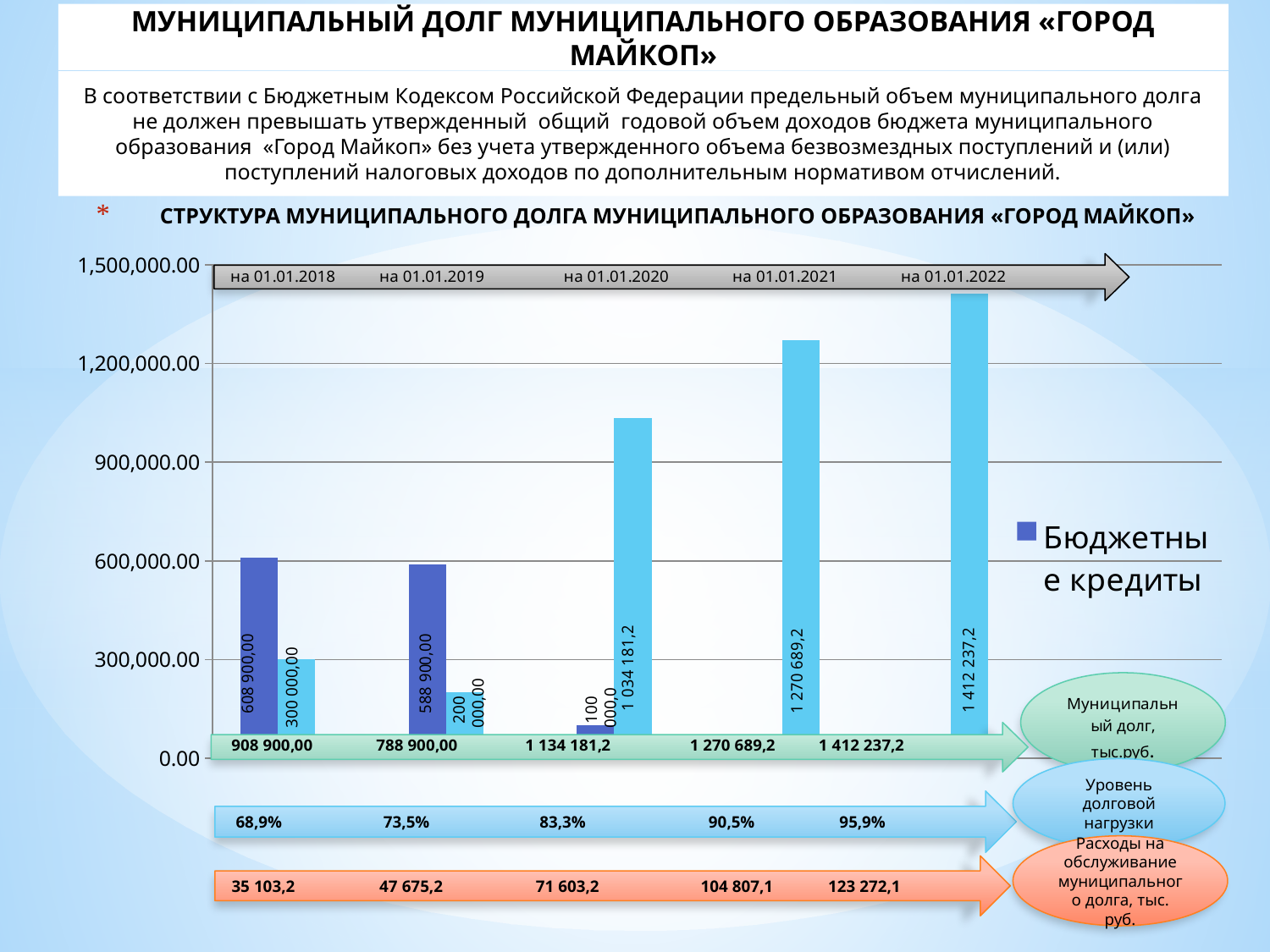
What is the debt load level (Уровень долговой нагрузки) shown for 01.01.2022? 95,9% What is the total municipal debt (Муниципальный долг, тыс.руб.) shown for 01.01.2020? 1 134 181,2 On which date is the light blue bar the highest? на 01.01.2022 What kind of chart is used to show the structure of municipal debt? bar chart What is the difference between the Бюджетные кредиты values on 01.01.2018 and 01.01.2019? 20 000,00 How many dates are shown along the x axis of the chart? 5 What is the value of the Бюджетные кредиты bar on 01.01.2019? 588 900,00 Which is larger: the Бюджетные кредиты value on 01.01.2018 or on 01.01.2019? на 01.01.2018 What is the value labelled on the tallest light blue bar, on 01.01.2022? 1 412 237,2 Do the light blue bars rise or fall from 01.01.2020 to 01.01.2022? rise What is the value of the Бюджетные кредиты bar on 01.01.2018? 608 900,00 Is the value of the light blue bar on 01.01.2021 greater or less than 1,200,000.00? greater